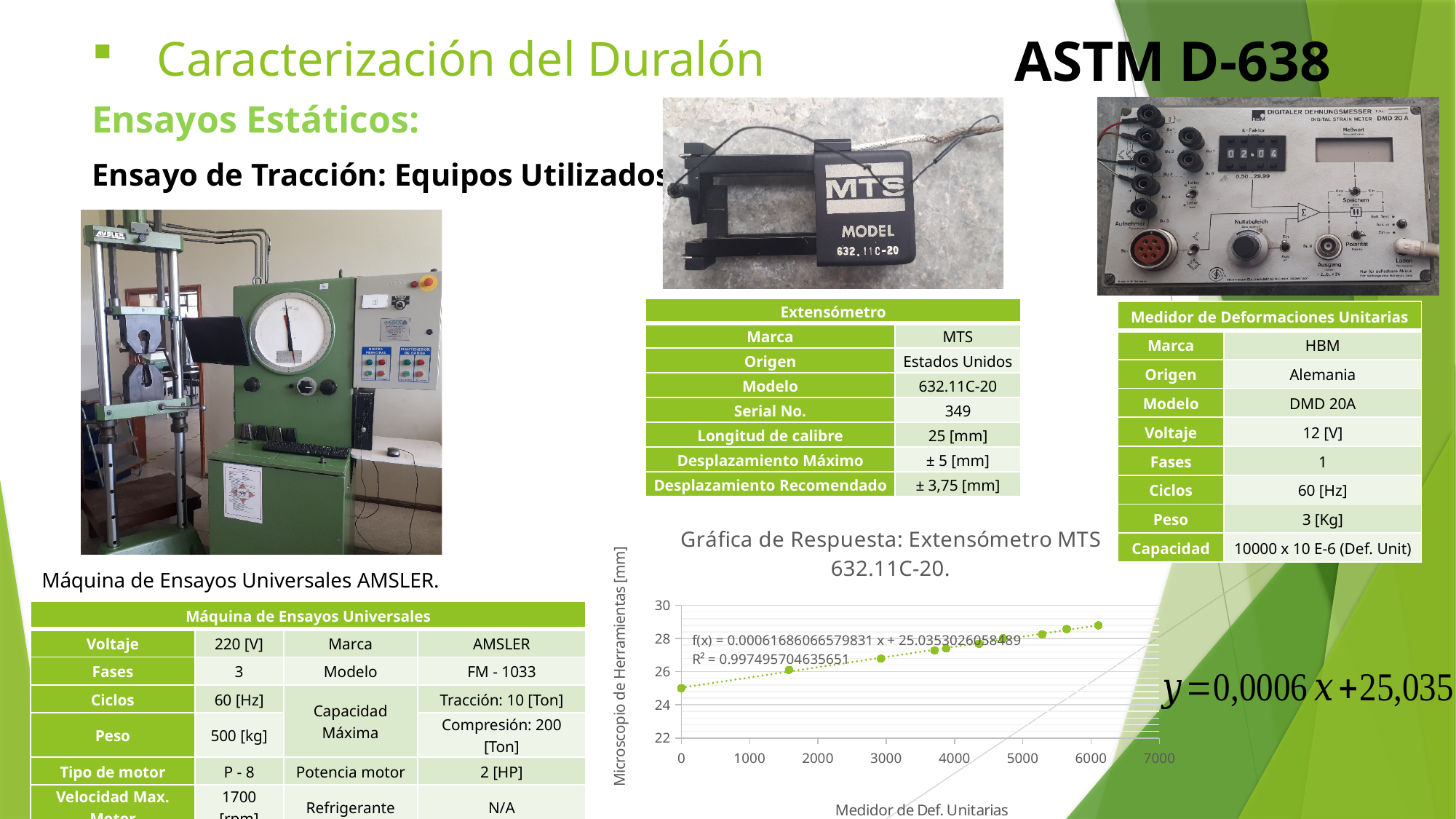
What is the label of the vertical axis of the chart? Microscopio de Herramientas [mm] What R² value is printed on the chart for the trendline? 0.997495704635651 What is the highest tick value shown on the vertical axis of the chart? 30 What trendline equation is printed on the chart? f(x) = 0.00061686066579831 x + 25.0353026058489 Which point has the highest y value: the one at x = 0 or the one near x = 6000? the one near x = 6000 Is the y value of the leftmost point (at x = 0) greater or less than 26? less What is the highest tick value shown on the horizontal axis of the chart? 7000 What is the title of the chart on the slide? Gráfica de Respuesta: Extensómetro MTS 632.11C-20. Do the plotted values rise or fall as the x-axis value increases? rise Is the y value of the point near x = 3000 greater or less than 28? less What kind of chart is shown on the slide? scatter chart Is the y value of the rightmost point (near x = 6000) greater or less than 28? greater